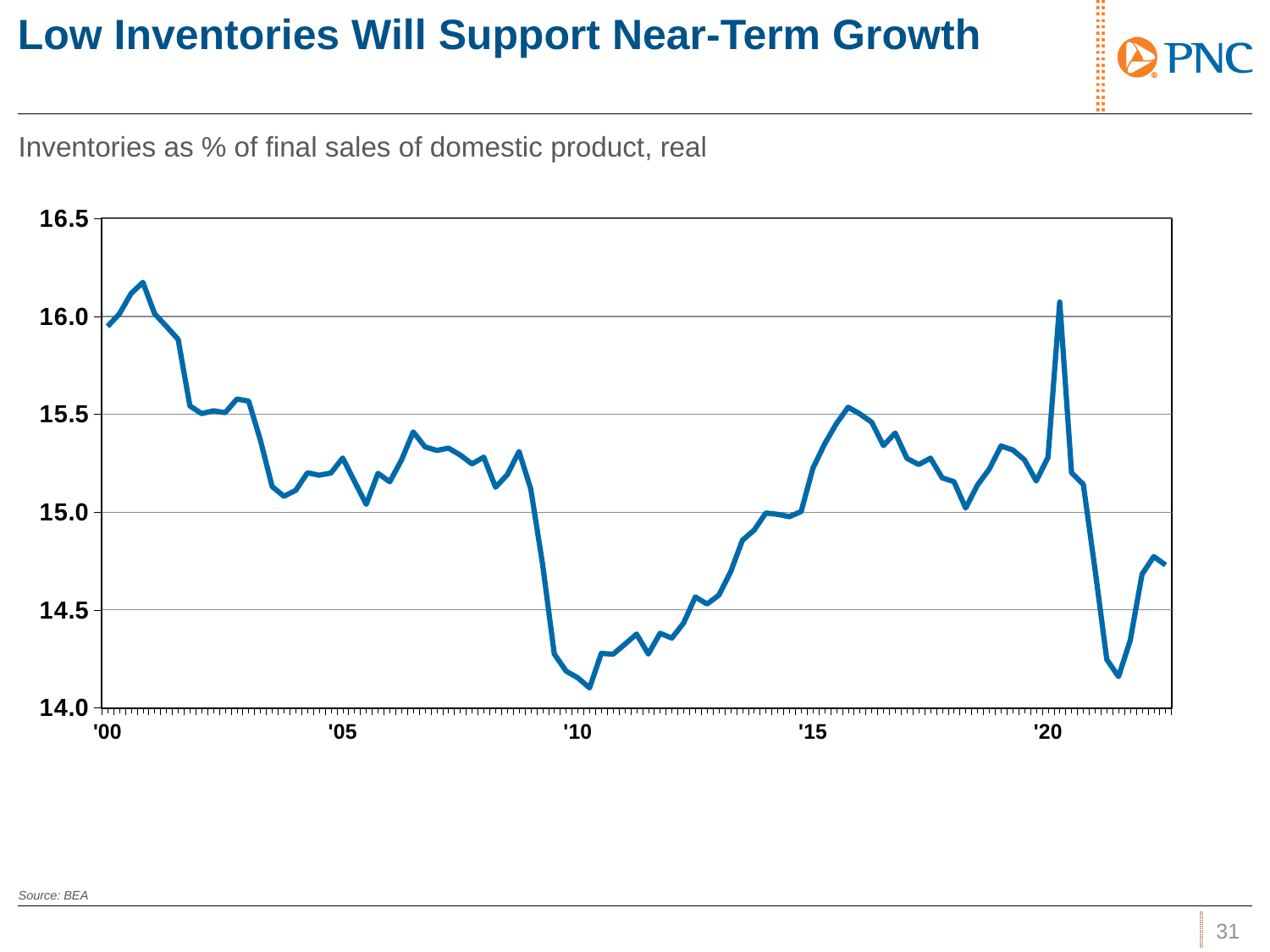
Between '00 and '10, does the line overall rise or fall? Fall How many data series are plotted on the chart? 1 Between '10 and '15, does the line overall rise or fall? Rise Is the value at '15 greater or less than 15.5? less What does the chart measure, according to the subtitle above it? Inventories as % of final sales of domestic product, real Is the lowest point of the line after '20 greater or less than 14.5? less Is the value at '00 greater or less than 15.5? greater What is the highest value shown on the y axis? 16.5 What kind of chart is shown on the slide? Line chart